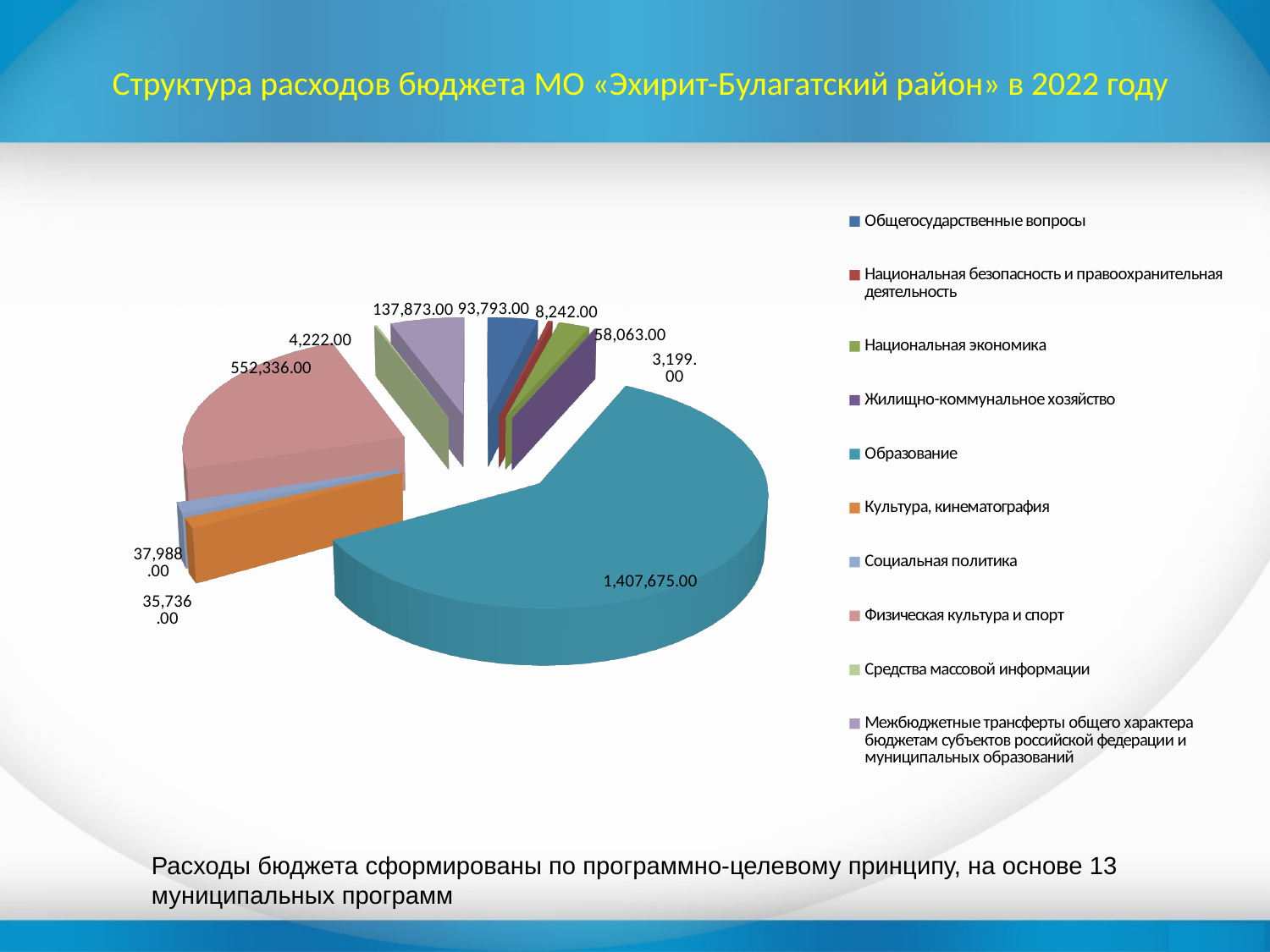
What is the title of the chart on the slide? Структура расходов бюджета МО «Эхирит-Булагатский район» в 2022 году What is the largest value printed on the pie chart? 1,407,675.00 Which category has the largest slice of the pie chart? Образование What is the value shown for Физическая культура и спорт? 552,336.00 What is the smallest value printed on the pie chart? 3,199.00 How many categories does the legend of the pie chart list? 10 Which is larger, the slice for Образование or the slice for Физическая культура и спорт? Образование What is the difference between the value for Образование (1,407,675.00) and the value for Физическая культура и спорт (552,336.00)? 855,339.00 Which legend entry is listed last in the pie chart's legend? Межбюджетные трансферты общего характера бюджетам субъектов российской федерации и муниципальных образований What kind of chart is shown on the slide? pie chart What is the value shown for Образование? 1,407,675.00 How many data labels are printed on the pie chart? 10